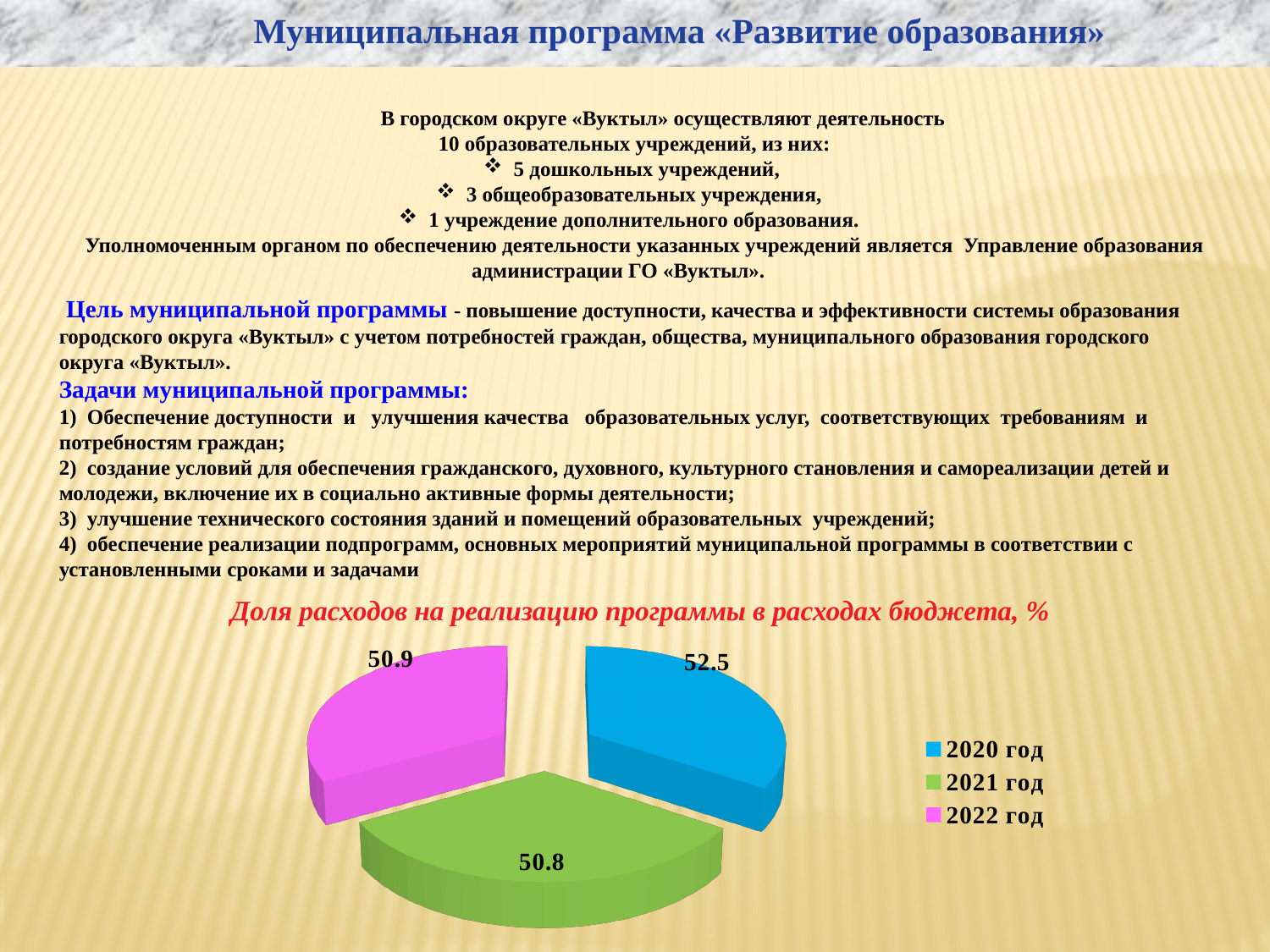
What kind of chart is shown on the slide? Pie chart What is the difference between the values for 2020 год and 2021 год? 1.7 What is the value for 2022 год in the pie chart? 50.9 What is the difference between the values for 2020 год and 2022 год? 1.6 How many slices does the pie chart have? 3 Which is larger, the value for 2020 год or the value for 2022 год? 2020 год How many entries does the legend of the pie chart list? 3 What is the value for 2021 год in the pie chart? 50.8 What is the title of the chart on the slide? Доля расходов на реализацию программы в расходах бюджета, % Which year has the highest value in the pie chart? 2020 год Which year has the lowest value in the pie chart? 2021 год What is the value for 2020 год in the pie chart? 52.5